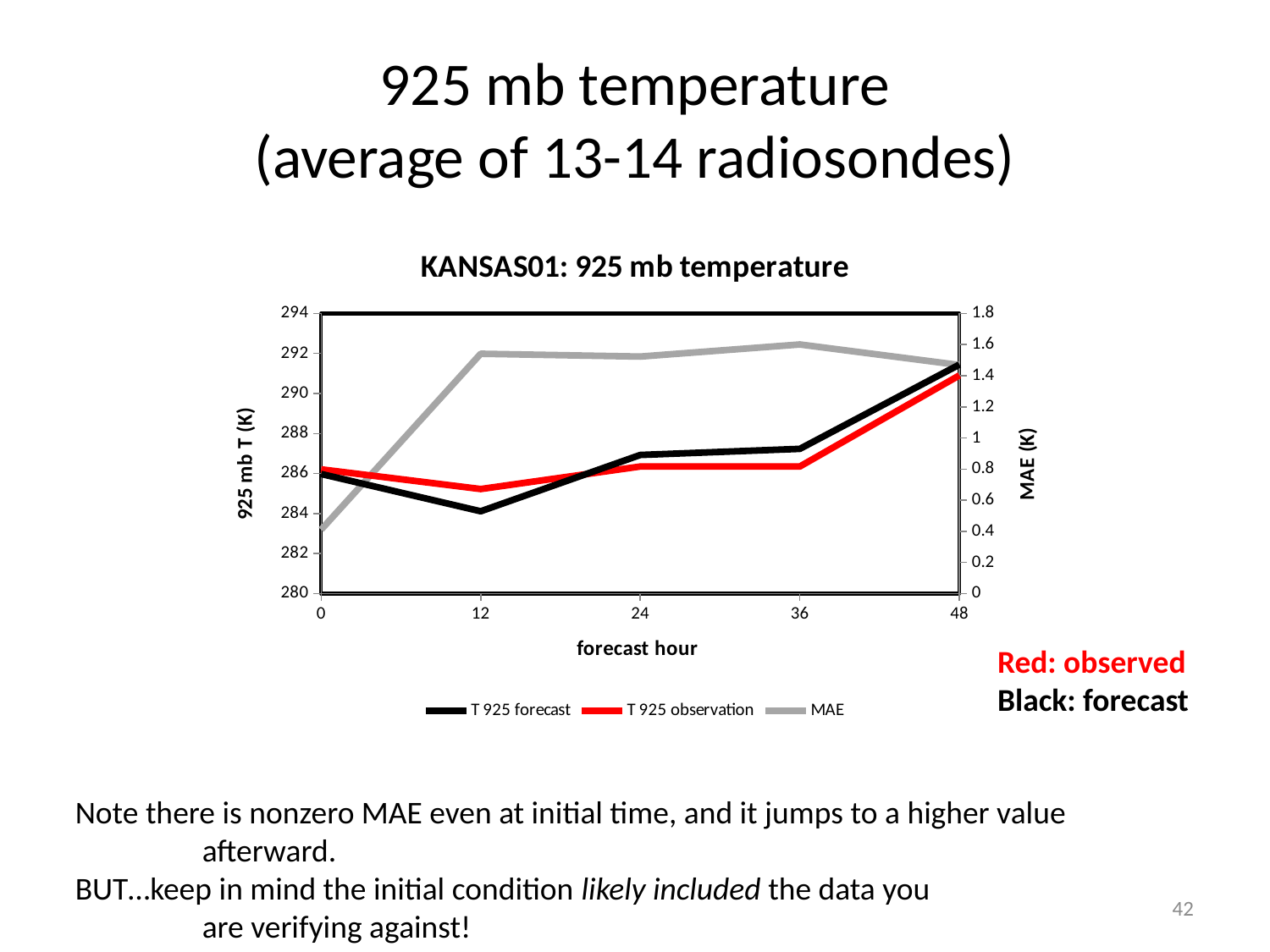
At which forecast hour is the MAE lowest? 0 How many series does the legend list? 3 Is the T 925 forecast value at forecast hour 12 greater or less than 286? less What is the title of the chart? KANSAS01: 925 mb temperature At which forecast hour is the T 925 forecast lowest? 12 At which forecast hour is the T 925 forecast highest? 48 What kind of chart is shown on the slide? line chart Is the MAE value at forecast hour 36 greater or less than 1.4? greater Is the MAE value at forecast hour 0 greater or less than 0.6? less At forecast hour 12, which is larger: the T 925 forecast or the T 925 observation? T 925 observation How many forecast hours are plotted along the x axis? 5